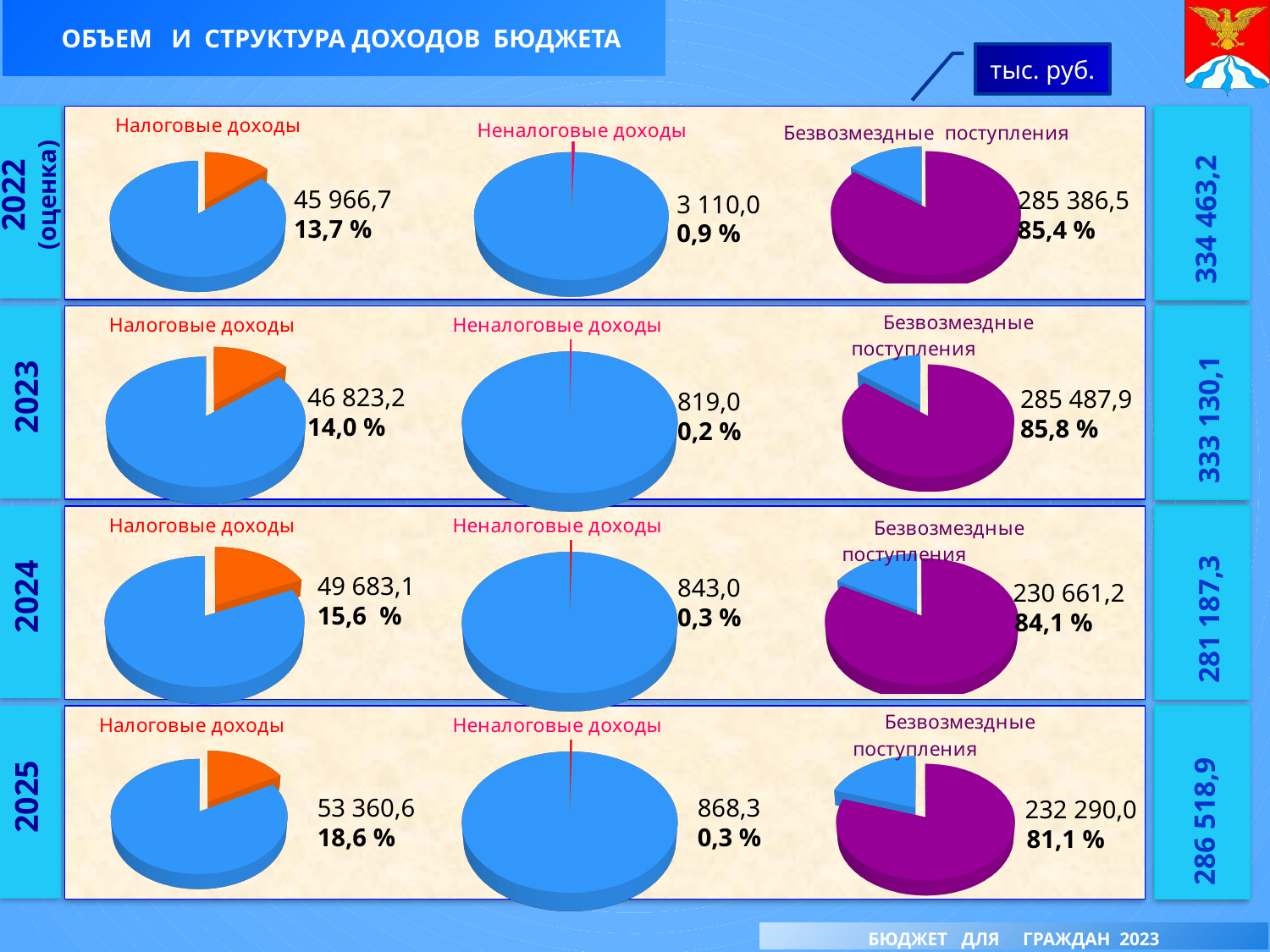
In the 2025 row, what share of the pie does 'Налоговые доходы' represent? 18,6 % In the 2024 row, what value is shown on the 'Неналоговые доходы' pie chart? 843,0 Which of the three categories has the largest share in the 2022 (оценка) row? Безвозмездные поступления What unit of measurement is indicated in the box at the top right of the slide? тыс. руб. What kind of charts are shown on the slide? Pie charts How many pie charts are shown on the slide? 12 In the 2022 (оценка) row, what value is shown on the 'Налоговые доходы' pie chart? 45 966,7 Does the share of 'Налоговые доходы' rise or fall from the 2022 row to the 2025 row? Rises In the 2023 row, what share of the pie does 'Безвозмездные поступления' represent? 85,8 % What is the difference between the 'Безвозмездные поступления' values in the 2023 row and the 2024 row? 54 826,7 Is the 'Налоговые доходы' value in the 2025 row larger or smaller than in the 2024 row? Larger Which of the three categories has the smallest share in the 2024 row? Неналоговые доходы